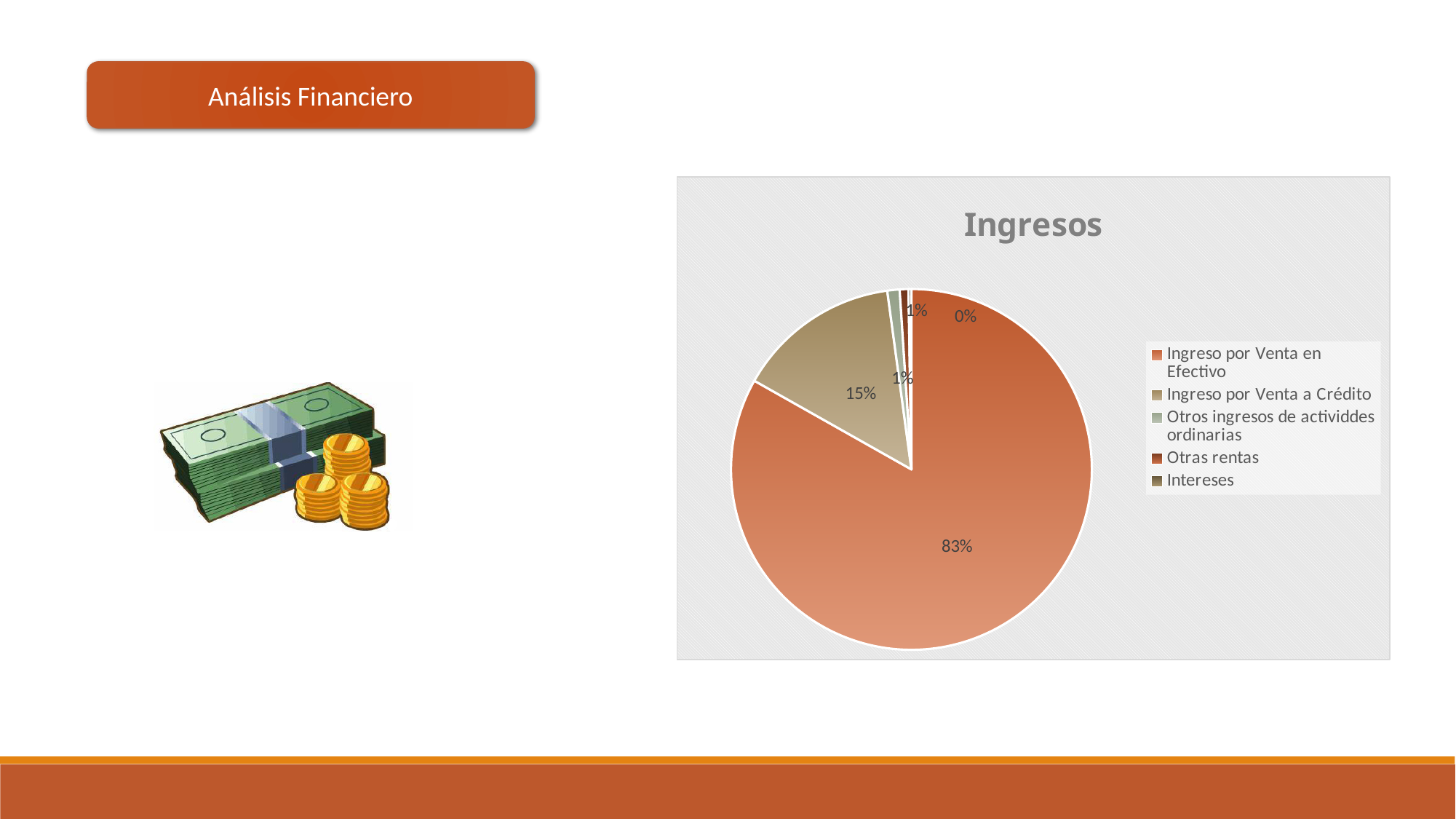
Which is larger, Ingreso por Venta a Crédito or Otras rentas? Ingreso por Venta a Crédito What is the difference in percentage points between Ingreso por Venta en Efectivo and Ingreso por Venta a Crédito? 68 What percentage is shown for Otras rentas? 1% Which category has the smallest slice of the pie? Intereses What kind of chart is shown on the slide? pie chart Which category has the largest slice of the pie? Ingreso por Venta en Efectivo What percentage is shown for Ingreso por Venta a Crédito? 15% What share of the pie does Ingreso por Venta en Efectivo represent? 83% What percentage is shown for Intereses? 0% What is the title of the chart? Ingresos How many categories does the legend list? 5 Which legend entry is shown in the dark red colour? Otras rentas